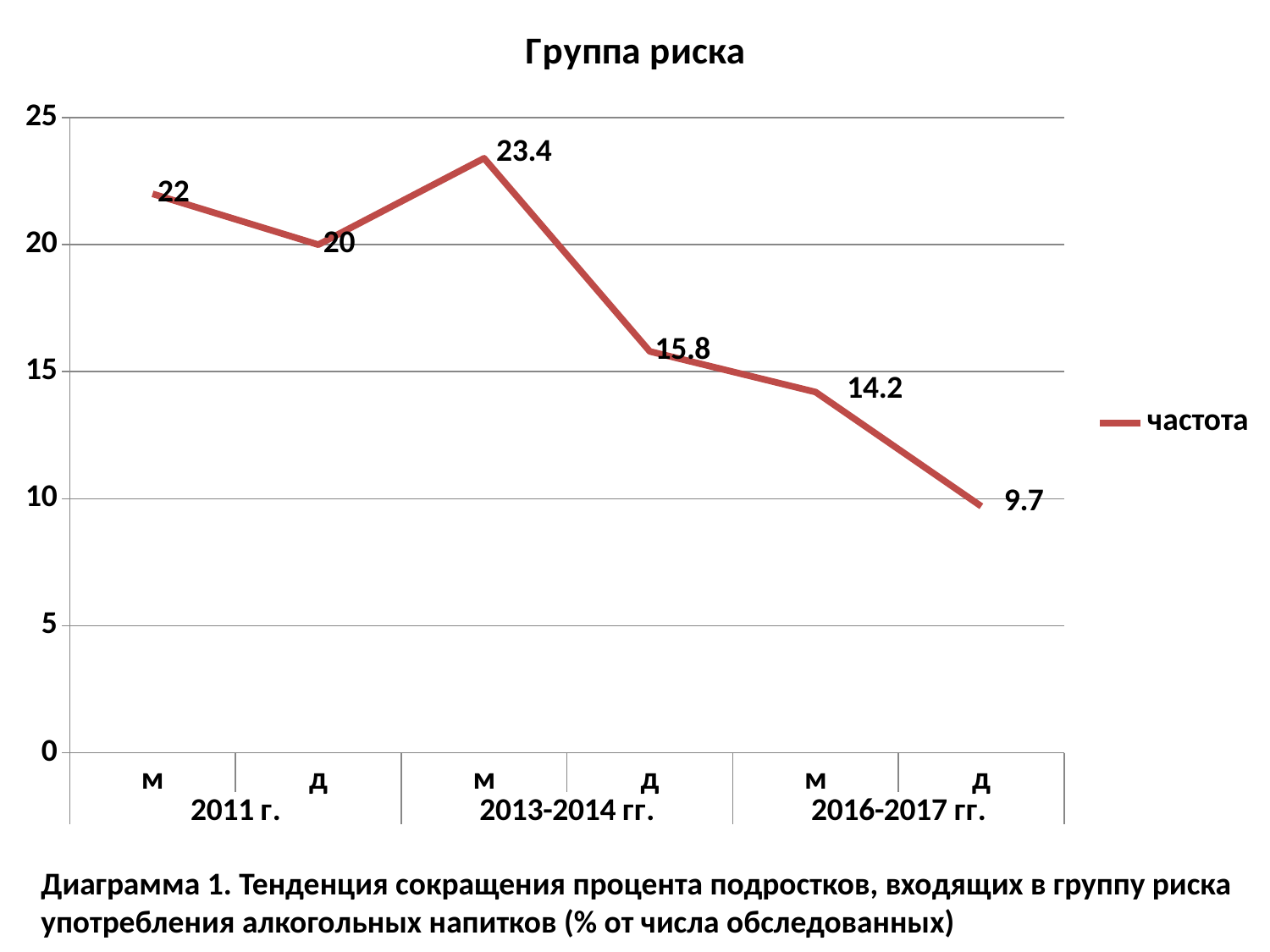
Is the value for м in 2016-2017 гг. greater or less than 15? less What is the value for д in 2013-2014 гг.? 15.8 What is the difference between the value for м in 2013-2014 гг. and the value for д in 2013-2014 гг.? 7.6 How many data points are plotted on the chart? 6 How many series does the legend list? 1 What kind of chart is shown? line chart What is the title of the chart? Группа риска Which point has the lowest value? д, 2016-2017 гг. Which point has the highest value? м, 2013-2014 гг. Which is larger: the value for м in 2011 г. or the value for д in 2011 г.? м in 2011 г. What is the value for м in 2011 г.? 22 What is the value for д in 2016-2017 гг.? 9.7